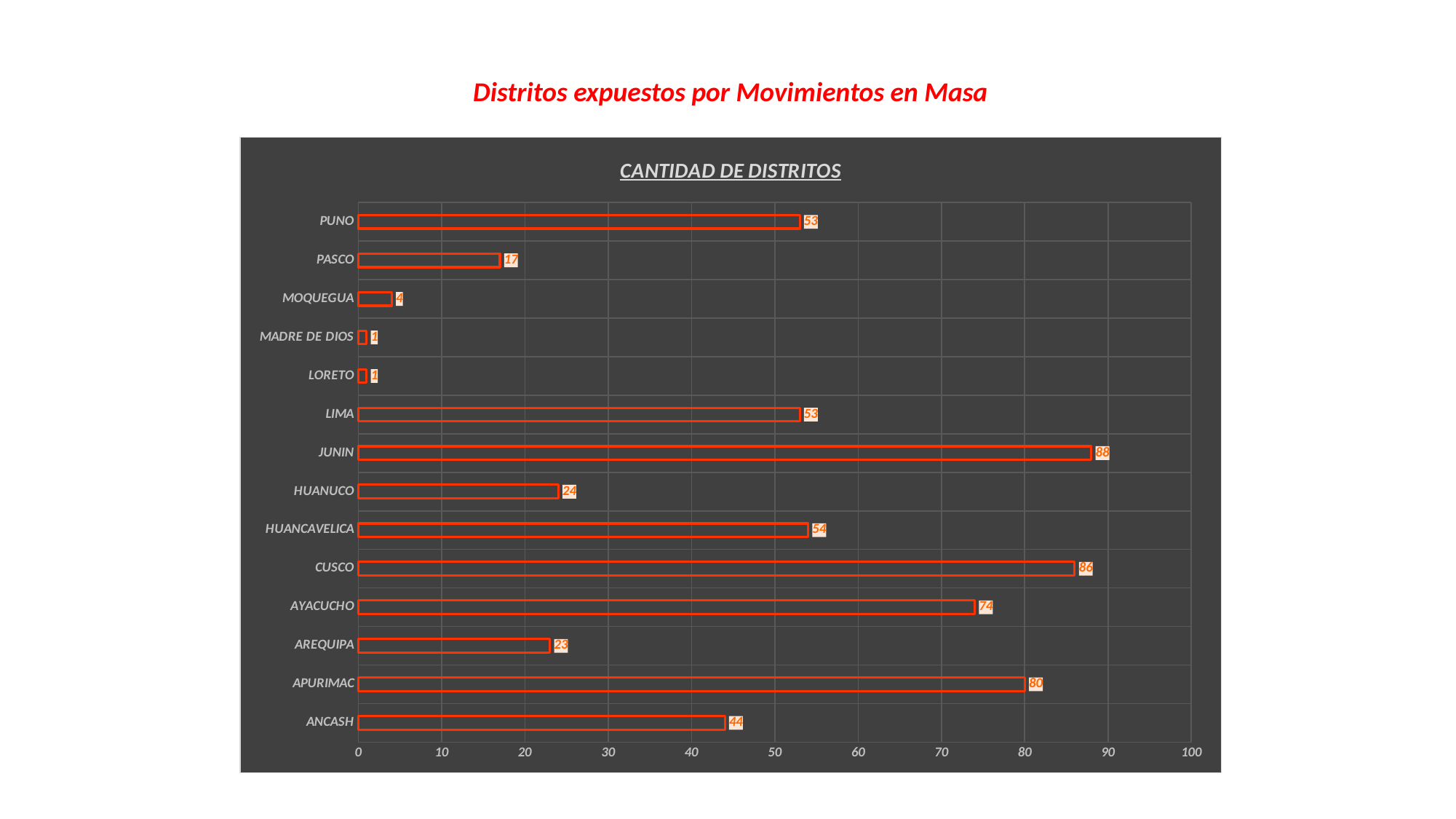
What is the value for MOQUEGUA? 4 What is the value for JUNIN? 88 What is the value for HUANCAVELICA? 54 What kind of chart is shown on the slide? bar chart What is the value for ANCASH? 44 How many categories are shown on the chart? 14 Which is larger, the value for APURIMAC or the value for AYACUCHO? APURIMAC Is the value for PASCO greater or less than 20? less What is the difference between the values for PUNO and PASCO? 36 What is the title of the chart? CANTIDAD DE DISTRITOS What is the difference between the values for CUSCO and AYACUCHO? 12 Which category has the highest value? JUNIN